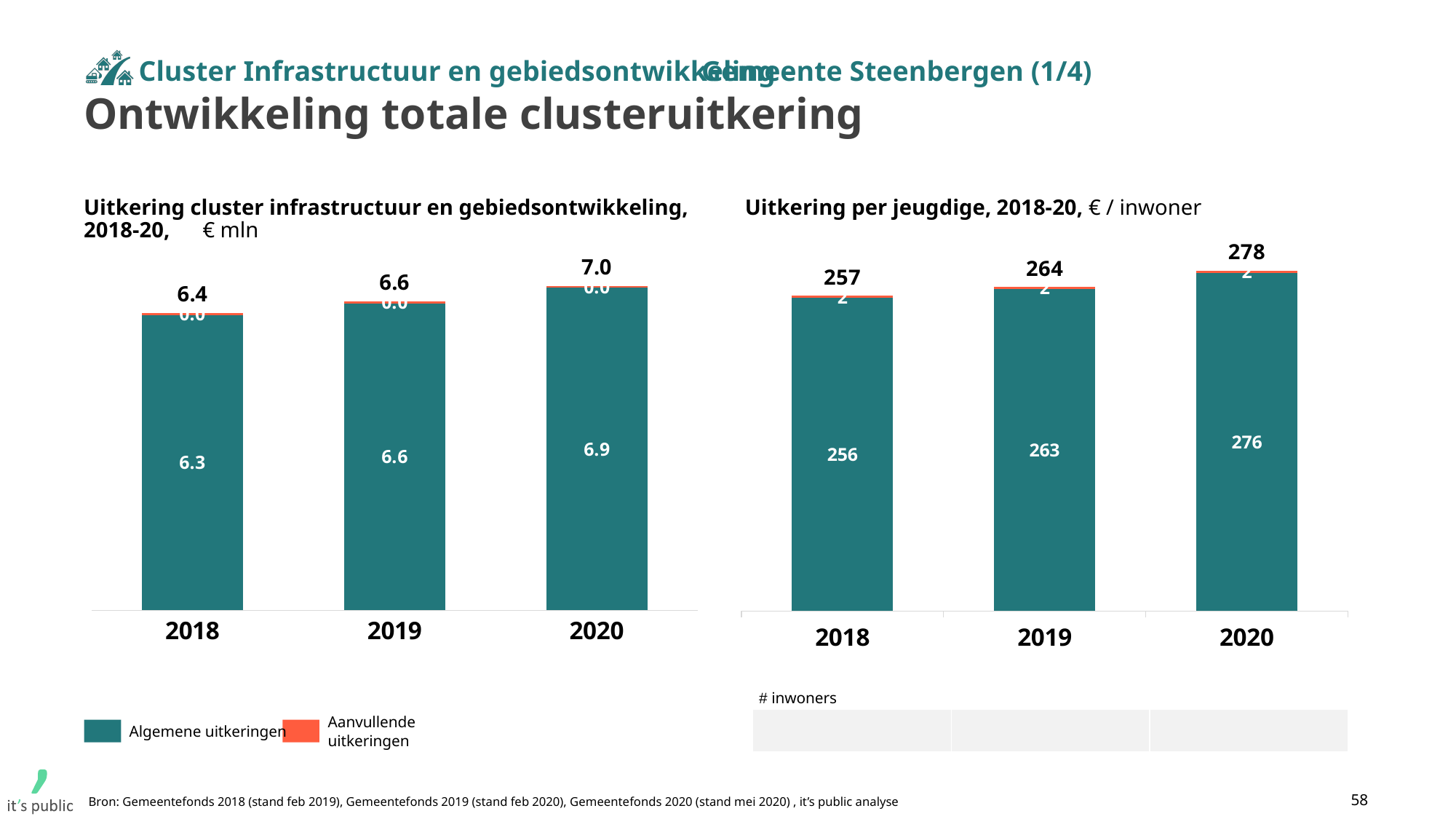
In the right chart (Uitkering per jeugdige), how many years are shown on the x axis? 3 In the right chart (Uitkering per jeugdige), what is the total value of the bar for 2019? 264 In the right chart (Uitkering per jeugdige), what is the difference between the totals for 2020 and 2018? 21 In the left chart (Uitkering cluster infrastructuur en gebiedsontwikkeling), what is the value of Algemene uitkeringen for 2018? 6.3 In the left chart (Uitkering cluster infrastructuur en gebiedsontwikkeling), which year has the highest total? 2020 What kind of chart is the left chart (Uitkering cluster infrastructuur en gebiedsontwikkeling)? stacked bar chart In the left chart (Uitkering cluster infrastructuur en gebiedsontwikkeling), what is the total value of the bar for 2020? 7.0 In the left chart (Uitkering cluster infrastructuur en gebiedsontwikkeling), do the totals rise or fall from 2018 to 2020? rise In the left chart (Uitkering cluster infrastructuur en gebiedsontwikkeling), what is the difference between the Algemene uitkeringen values for 2020 and 2018? 0.6 How many series does the legend list for the left chart? 2 In the right chart (Uitkering per jeugdige), which year has the lowest total? 2018 In the right chart (Uitkering per jeugdige), what is the value of Algemene uitkeringen for 2020? 276